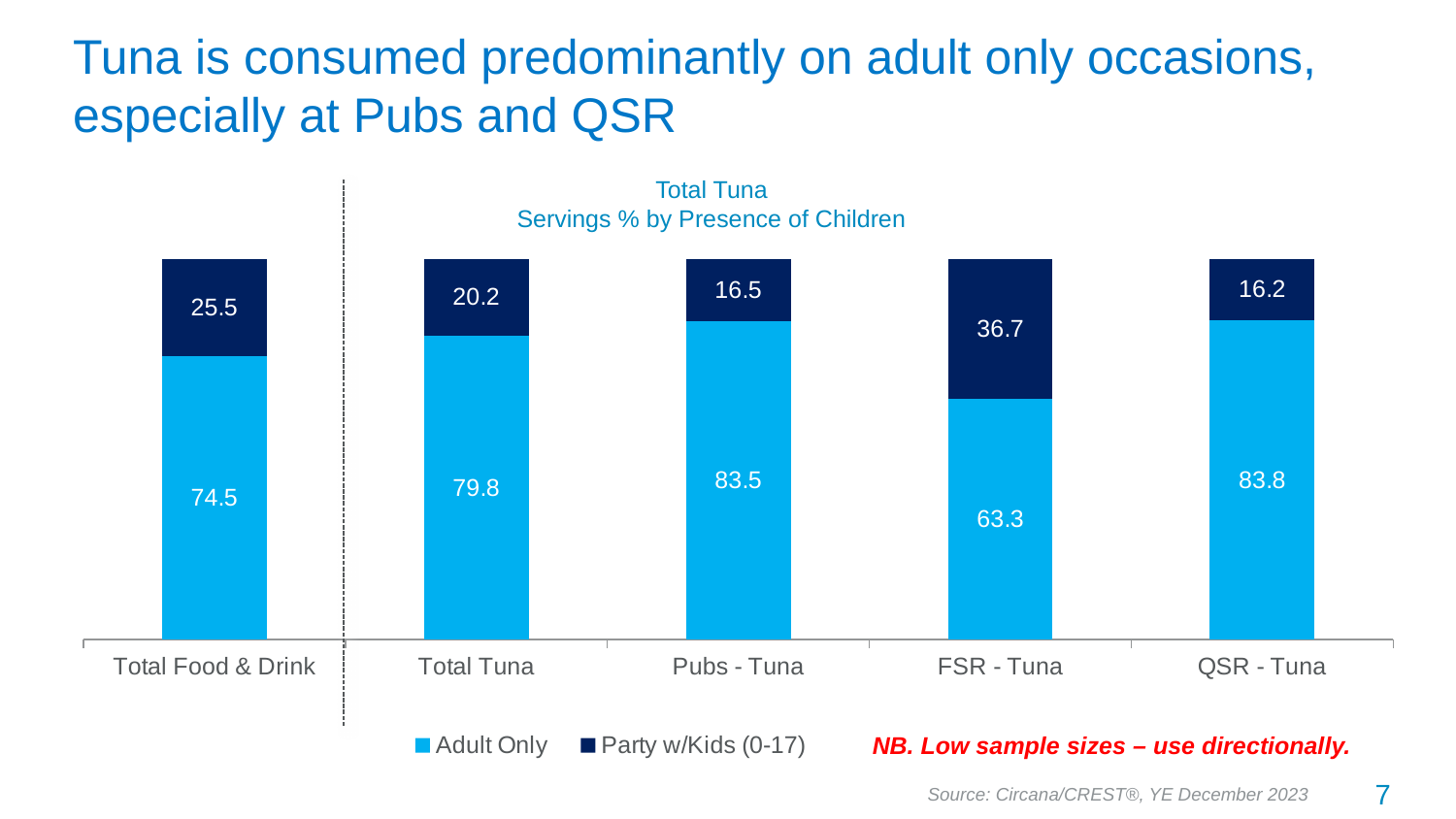
What is the Adult Only value for QSR - Tuna? 83.8 What is the difference between the Adult Only values for Pubs - Tuna and FSR - Tuna? 20.2 Which is larger, the Party w/Kids (0-17) value for Total Food & Drink or for Total Tuna? Total Food & Drink What is the Party w/Kids (0-17) value for FSR - Tuna? 36.7 Which category has the highest Adult Only value? QSR - Tuna Which category has the highest Party w/Kids (0-17) value? FSR - Tuna How many categories are shown on the x axis? 5 How many series does the legend list? 2 Which category has the lowest Adult Only value? FSR - Tuna What is the Adult Only value for Total Food & Drink? 74.5 What is the total of the stacked bar for Total Tuna? 100 What kind of chart is shown? Stacked bar chart